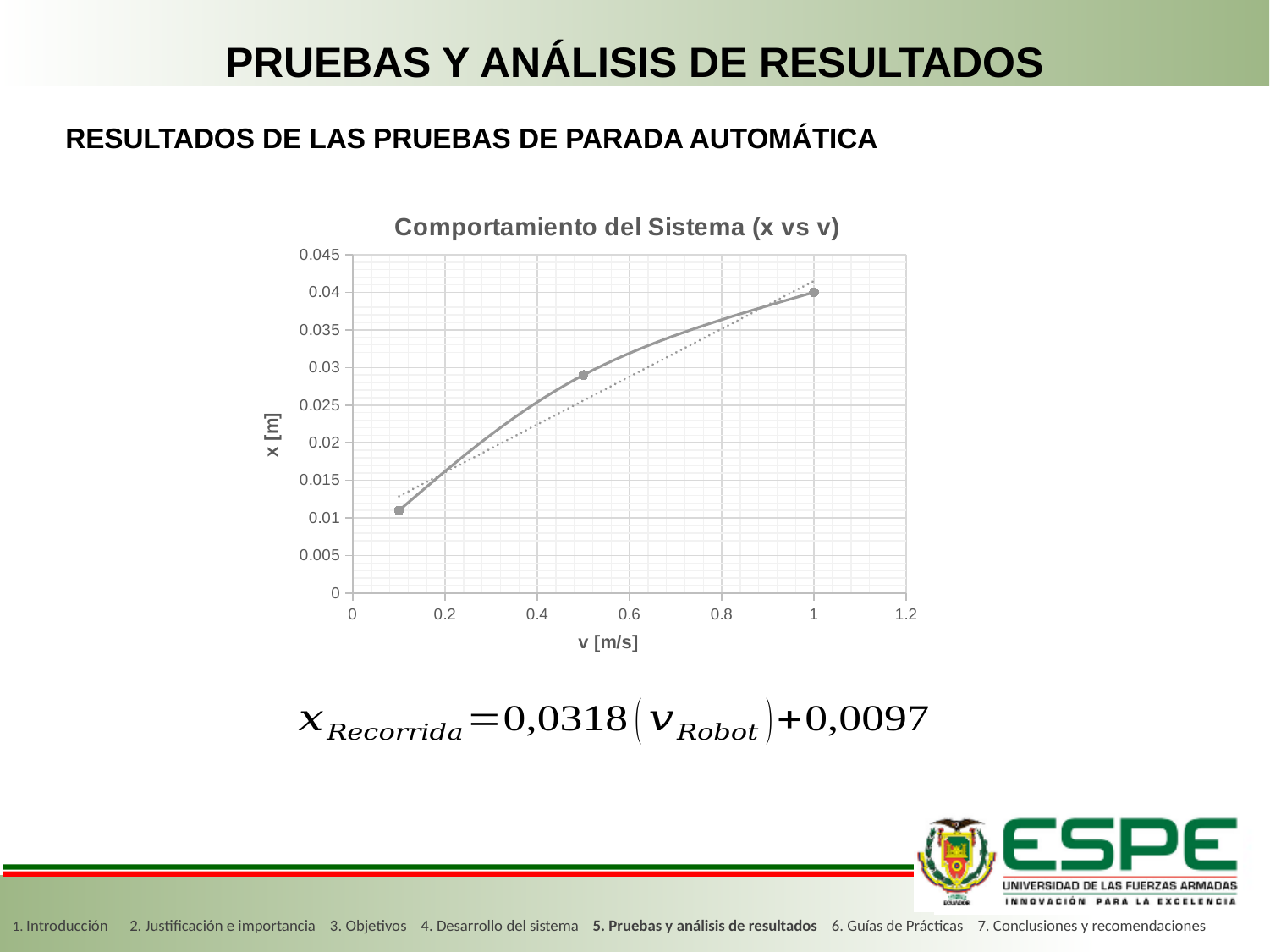
At which v value does the chart reach its highest x value? 1 What is the label of the vertical axis of the chart? x [m] Is the x value of the data point at v = 1 greater or less than 0.045? less What is the x value of the data point at v = 1 m/s? 0.04 Is the x value of the data point at v = 0.5 greater or less than 0.025? greater What is the title of the chart? Comportamiento del Sistema (x vs v) What kind of chart is shown on the slide? line chart Do the plotted x values rise or fall as v increases along the horizontal axis? rise How many data points are plotted on the chart? 3 Is the lowest x value on the chart at the leftmost or the rightmost data point? leftmost Which data point has the highest x value: the one at v = 1 or the one at v = 0.5? the one at v = 1 Is the x value of the leftmost data point greater or less than 0.015? less